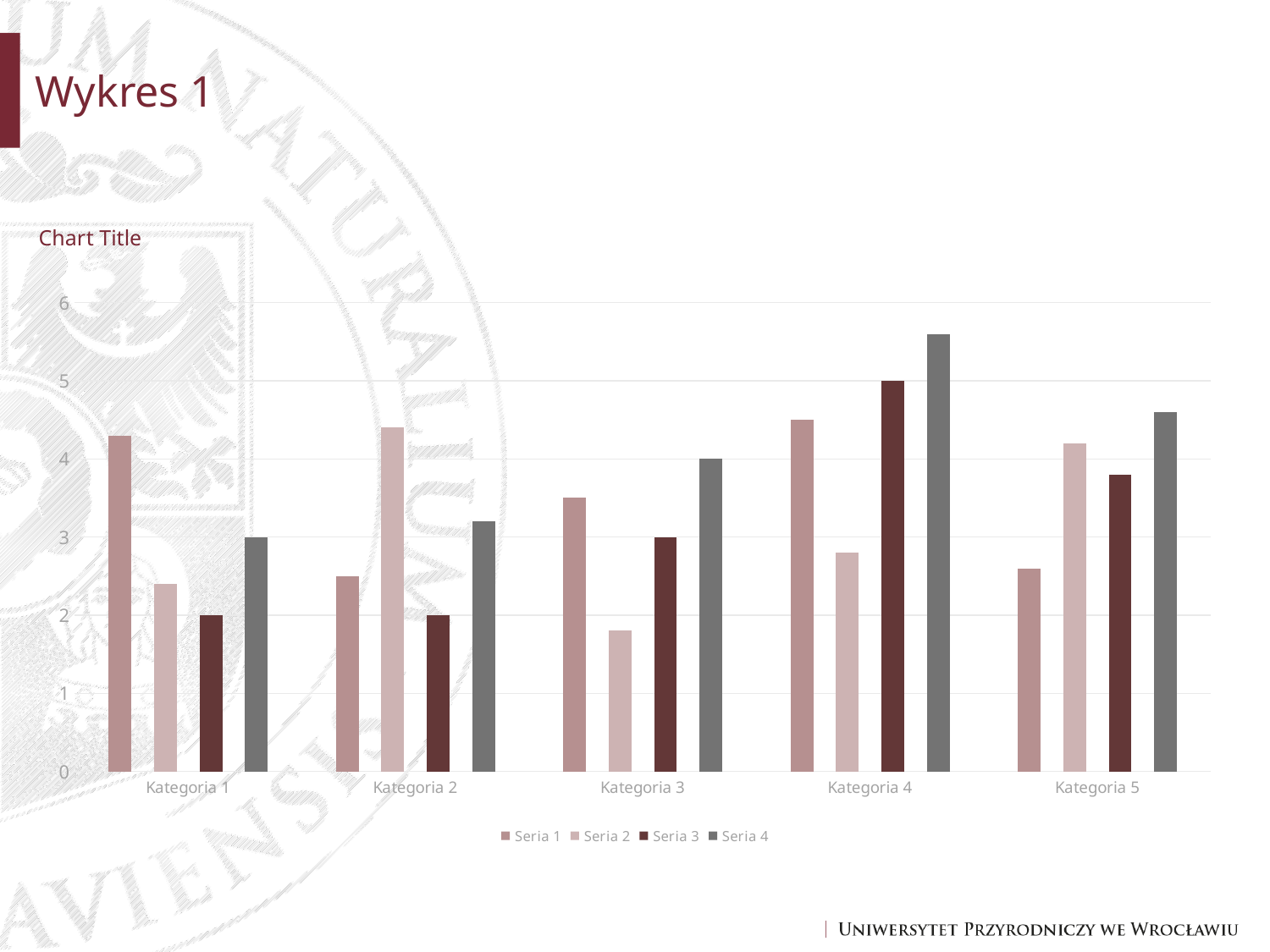
Is the value of Seria 2 for Kategoria 3 greater or less than 2? less How many series does the legend list? 4 What kind of chart is shown on the slide? bar chart For Kategoria 4, which is larger: Seria 2 or Seria 3? Seria 3 Which category has the lowest value for Seria 2? Kategoria 3 How many categories are shown on the x axis? 5 Is the value of Seria 4 for Kategoria 4 greater or less than 5? greater What is the title of the chart? Chart Title What is the value of Seria 3 for Kategoria 1? 2 Which category has the highest value for Seria 4? Kategoria 4 What is the value of Seria 3 for Kategoria 4? 5 What is the value of Seria 4 for Kategoria 3? 4